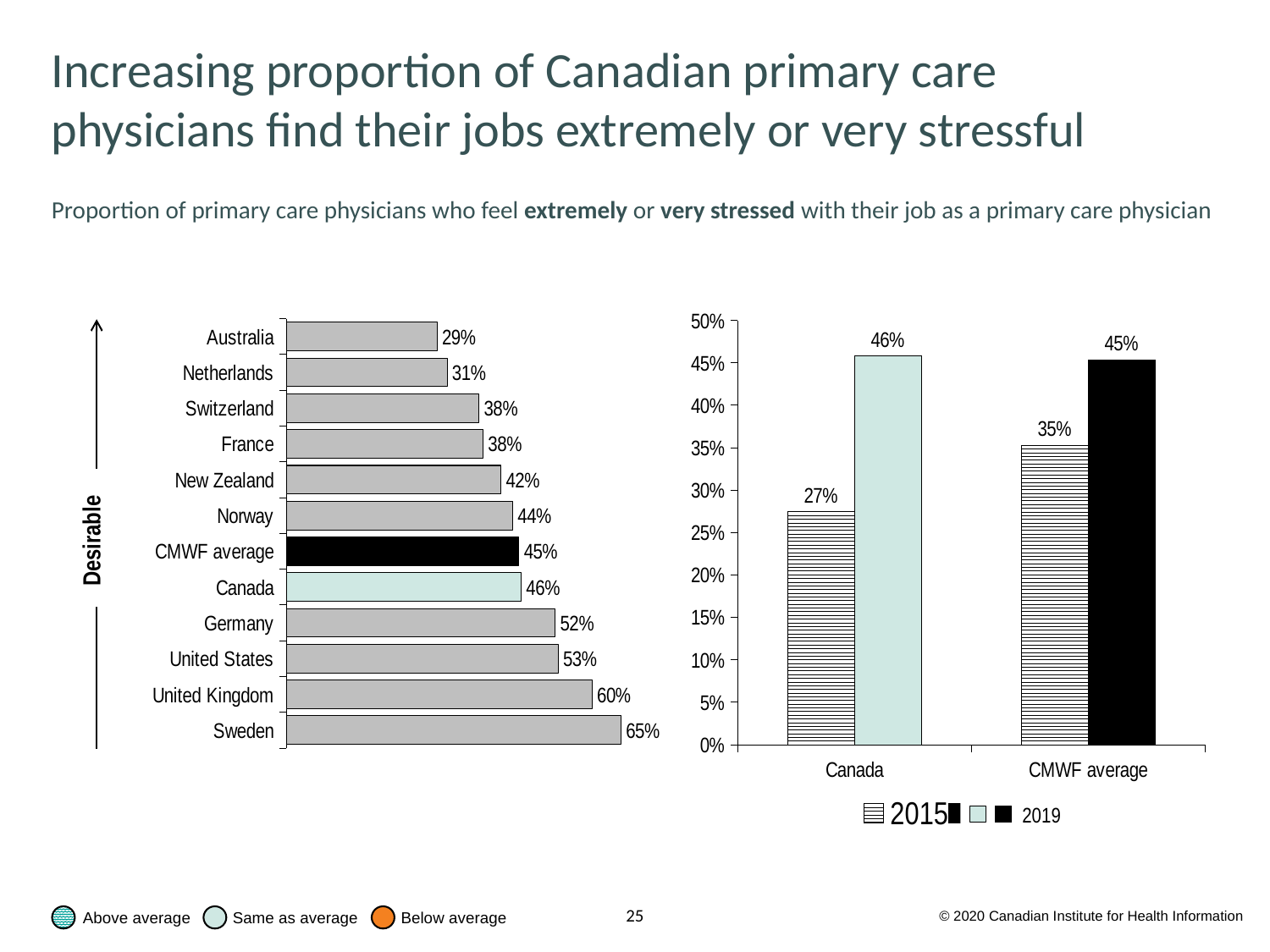
In the right chart, what is the 2015 value for Canada? 27% In the left bar chart, which category has the highest value? Sweden In the left bar chart, which country has the lowest value? Australia What type of chart is the chart on the right of the slide? Bar chart In the left bar chart, what is the value for Norway? 44% In the right chart, what is the 2019 value for CMWF average? 45% How many series does the legend of the right chart list? 2 How many categories are shown in the left bar chart? 12 In the left bar chart, what is the value for Sweden? 65% In the left bar chart, what is the difference between the United Kingdom and Germany? 8% In the left bar chart, which is larger, the value for the United States or the value for New Zealand? United States In the right chart, what is the difference between Canada's 2019 and 2015 values? 19%